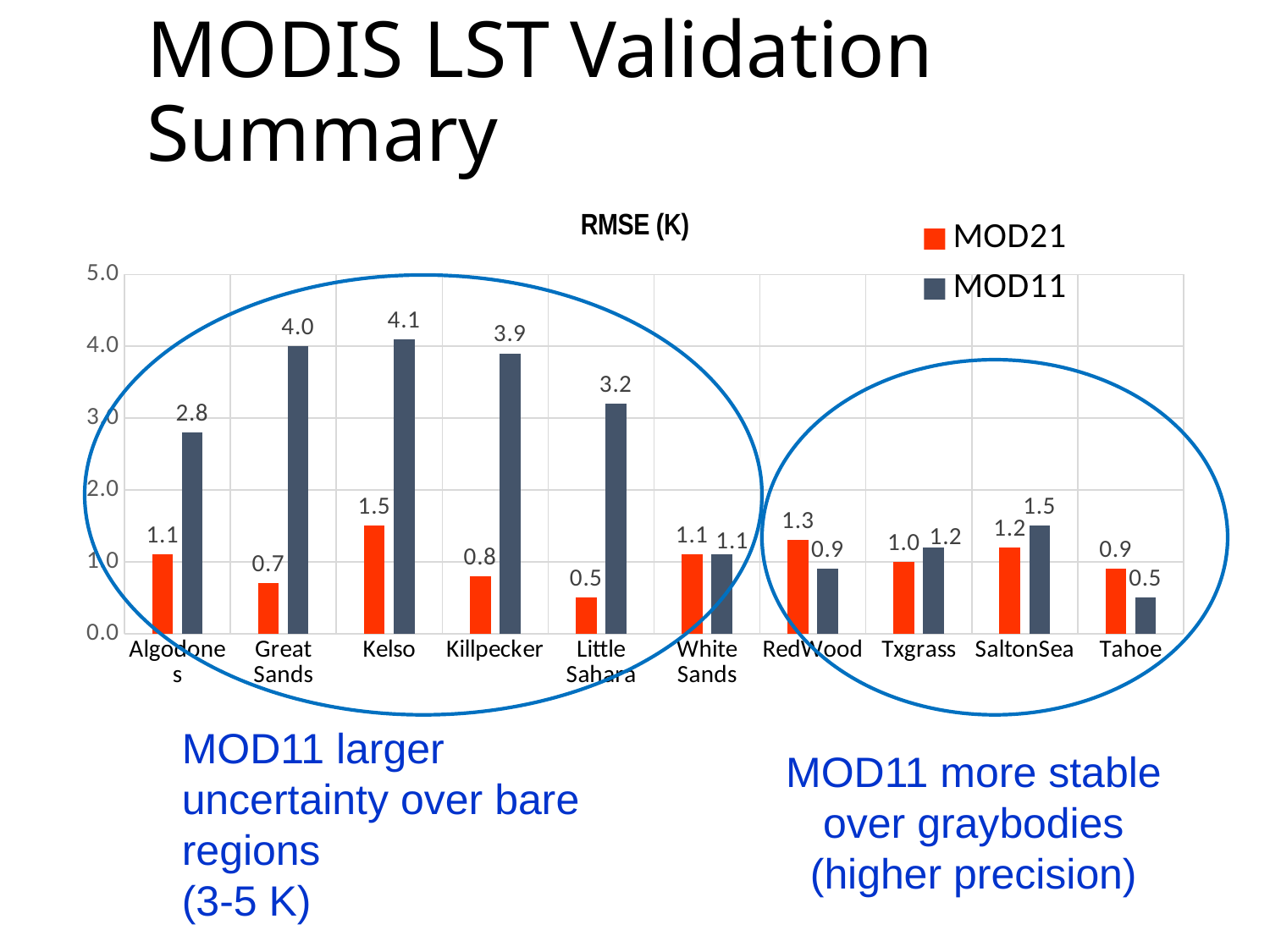
How many series does the legend list? 2 What is the difference between the MOD11 and MOD21 values for Great Sands? 3.3 What is the MOD21 RMSE value for Little Sahara? 0.5 Is the MOD11 value for Killpecker greater or less than 3.0? greater What is the MOD11 RMSE value for Kelso? 4.1 How many sites are shown on the x axis? 10 Which site has the highest MOD11 RMSE? Kelso What is the MOD11 value for Tahoe? 0.5 Which is larger for RedWood, the MOD21 value or the MOD11 value? MOD21 What is the title of the chart? RMSE (K) Which site has the lowest MOD21 RMSE? Little Sahara What kind of chart is shown? bar chart